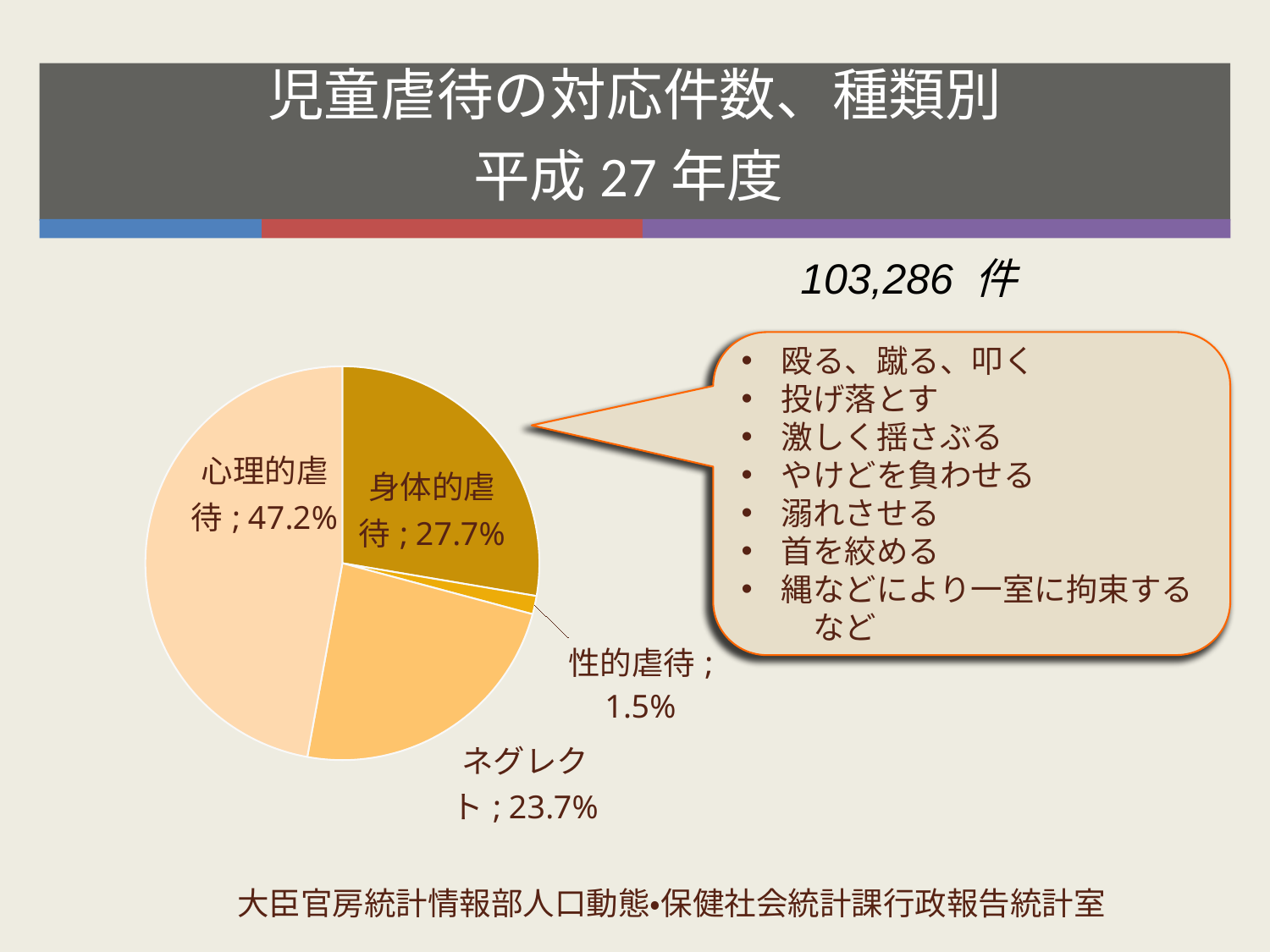
Which category has the smallest slice of the pie? 性的虐待 What kind of chart is shown on the slide? Pie chart What is the difference in percentage points between 心理的虐待 and 身体的虐待? 19.5 What share of the pie does 身体的虐待 account for? 27.7% What share of the pie does 心理的虐待 account for? 47.2% What share of the pie does ネグレクト account for? 23.7% Which is larger, the share for 身体的虐待 or the share for ネグレクト? 身体的虐待 How many categories are shown in the pie chart? 4 Which category has the largest slice of the pie? 心理的虐待 What total number of cases is shown above the chart? 103,286 件 What is the difference in percentage points between 身体的虐待 and ネグレクト? 4.0 What share of the pie does 性的虐待 account for? 1.5%